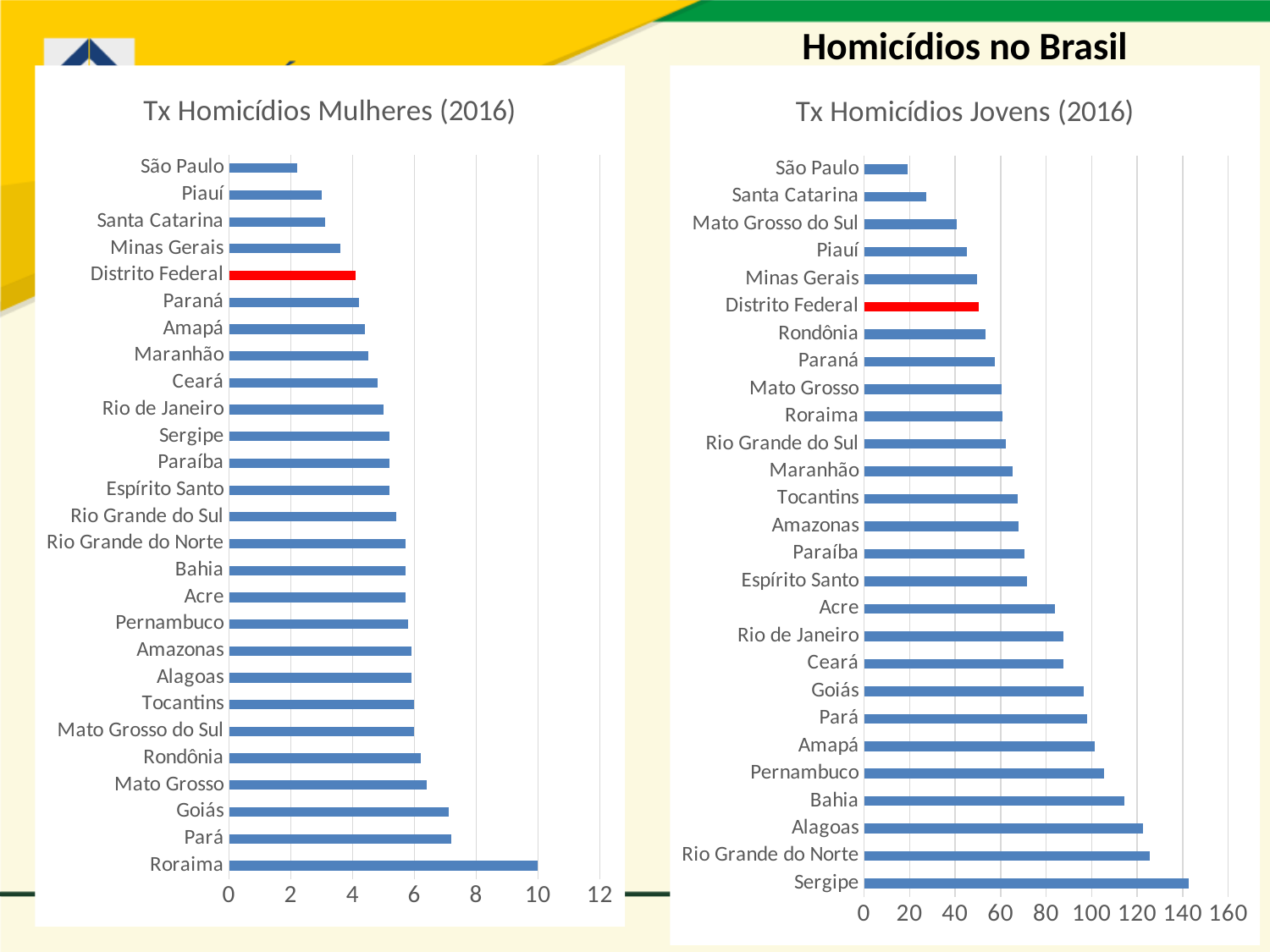
In the chart titled 'Tx Homicídios Jovens (2016)', which state has the lowest value? São Paulo In the chart titled 'Tx Homicídios Mulheres (2016)', is the value for Roraima greater or less than 8? greater How many states are shown in the chart titled 'Tx Homicídios Mulheres (2016)'? 27 What kind of chart is the chart titled 'Tx Homicídios Jovens (2016)'? bar chart In the chart titled 'Tx Homicídios Jovens (2016)', which state has the highest value? Sergipe In the chart titled 'Tx Homicídios Mulheres (2016)', which state has the lowest value? São Paulo In the chart titled 'Tx Homicídios Jovens (2016)', which is larger, the value for Alagoas or the value for Acre? Alagoas In the chart titled 'Tx Homicídios Jovens (2016)', is the value for Sergipe greater or less than 120? greater In the chart titled 'Tx Homicídios Mulheres (2016)', which state has the highest value? Roraima In the chart titled 'Tx Homicídios Jovens (2016)', is the value for Distrito Federal greater or less than 60? less In the chart titled 'Tx Homicídios Mulheres (2016)', which state's bar is coloured red? Distrito Federal